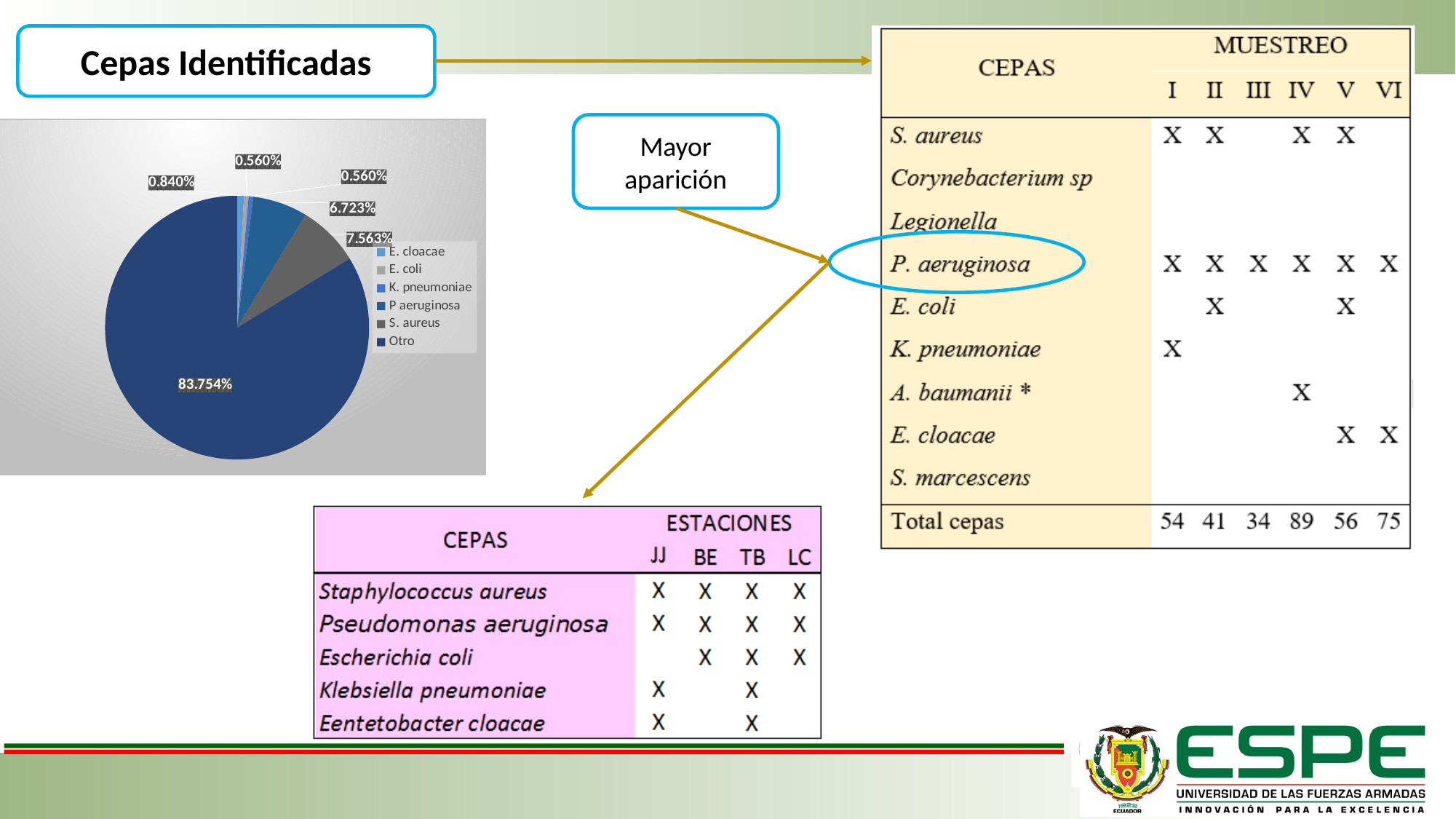
What is the smallest percentage value labelled on the pie chart? 0.560% What type of chart is shown on the slide? pie chart How many categories does the pie chart's legend list? 6 What is the difference between the S. aureus and P aeruginosa percentages in the pie chart? 0.840% Is the share for Otro in the pie chart greater or less than 80%? greater What is the title in the box at the top left of the slide? Cepas Identificadas Which legend entry is listed last in the pie chart's legend? Otro What percentage is shown for P aeruginosa in the pie chart? 6.723% Which is larger in the pie chart, S. aureus or P aeruginosa? S. aureus What share of the pie does the 'Otro' slice represent? 83.754% What percentage is shown for S. aureus in the pie chart? 7.563% Which category has the largest slice in the pie chart? Otro